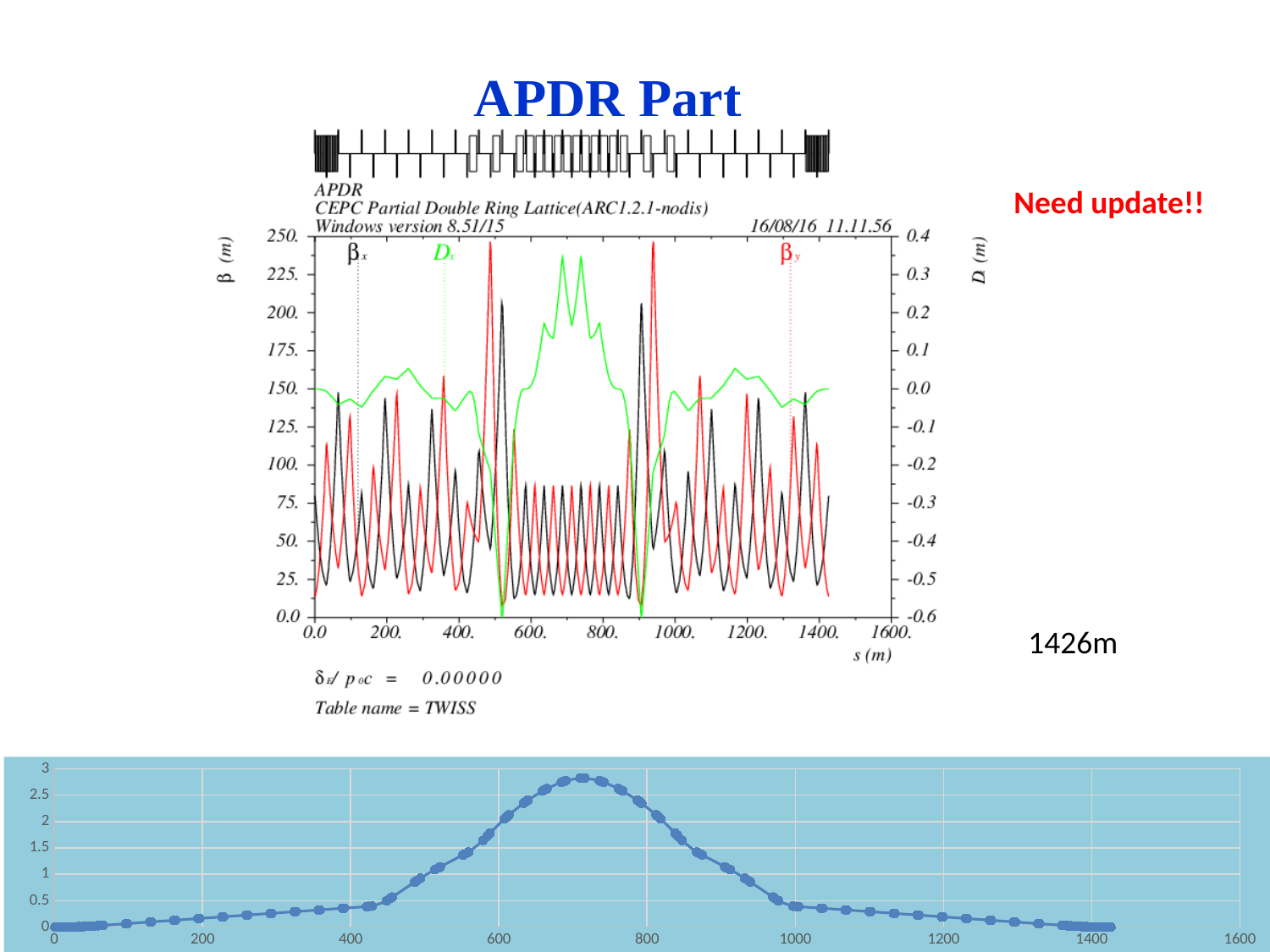
In the bottom chart, is the value at x = 200 greater or less than 0.5? less In the top chart, what are the three series labelled in the legend? βx, Dx, βy In the top chart, what is the maximum value shown on the left β (m) axis? 250 In the top chart, is the highest peak of βy greater or less than 225? greater In the top chart, is the highest peak of Dx greater or less than 0.3? greater What kind of chart is the bottom chart? line chart What kind of chart is the top chart? line chart In the top chart, how many series are labelled in the legend? 3 In the top chart, what is the title printed above the plot? CEPC Partial Double Ring Lattice(ARC1.2.1-nodis) In the bottom chart, do the values rise or fall between x = 800 and x = 1000? fall